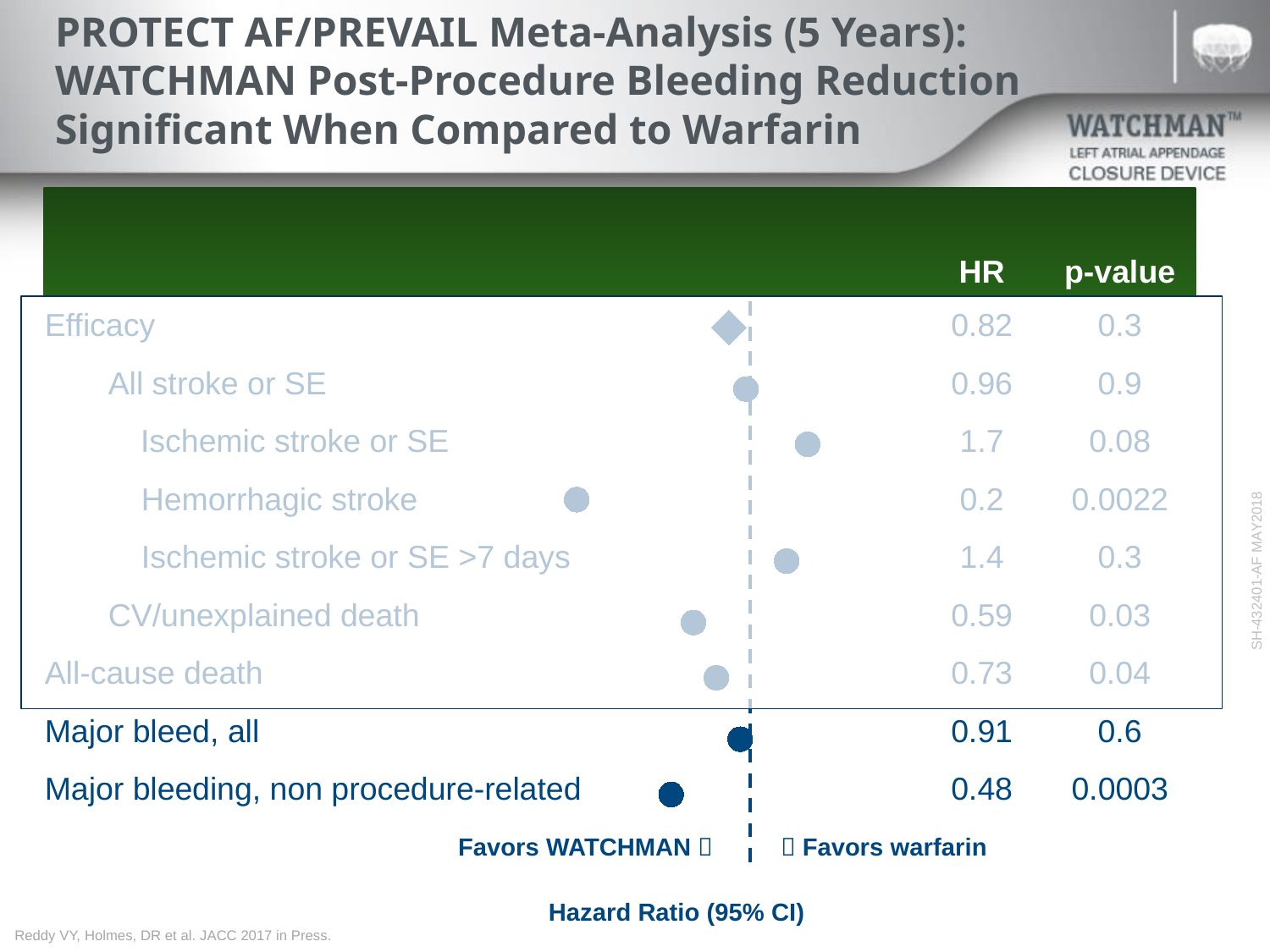
What is the hazard ratio (HR) for Major bleeding, non procedure-related? 0.48 Which has a larger hazard ratio: Ischemic stroke or SE, or All-cause death? Ischemic stroke or SE What is the p-value for Major bleed, all? 0.6 What is the HR for CV/unexplained death? 0.59 What kind of chart is shown on the slide? Forest plot What is the difference between the HR for Major bleed, all and the HR for Major bleeding, non procedure-related? 0.43 Which outcome has the highest hazard ratio? Ischemic stroke or SE How many outcomes are plotted in the chart? 9 Which outcome has the lowest hazard ratio? Hemorrhagic stroke What is the label of the horizontal axis of the chart? Hazard Ratio (95% CI) What is the p-value for Hemorrhagic stroke? 0.0022 Is the hazard ratio for Ischemic stroke or SE greater or less than 1? greater